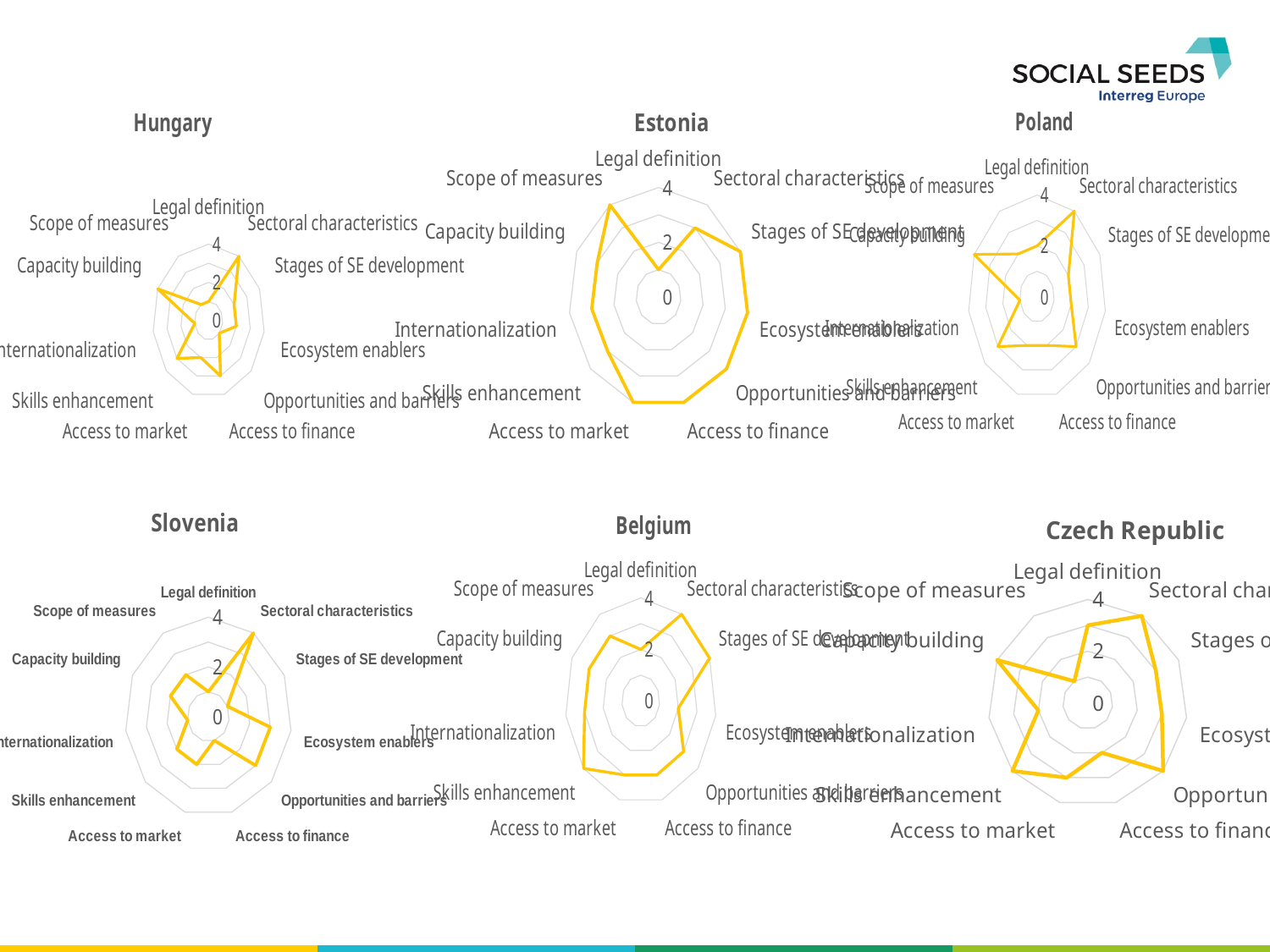
In the Slovenia chart, is the value for Legal definition greater or less than 2? less In the Estonia chart, is the value for Scope of measures greater or less than 2? greater In the Poland chart, is the value for Sectoral characteristics greater or less than 2? greater How many charts are shown on the slide? 6 How many categories (axes) does the Estonia radar chart have? 11 What is the title of the chart in the top-left corner of the slide? Hungary What kind of chart is used for the Hungary chart? radar chart